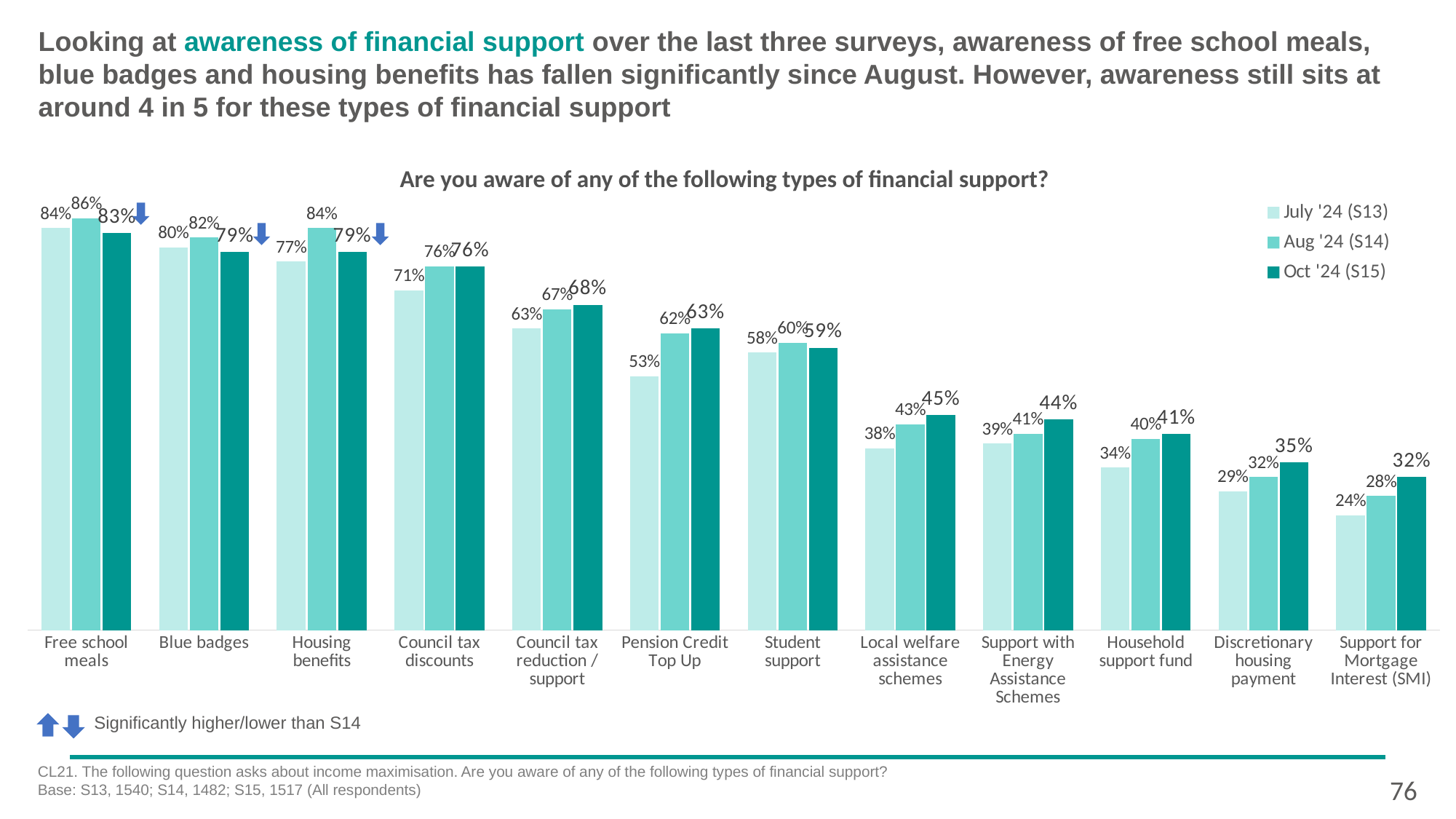
What is the title of the chart? Are you aware of any of the following types of financial support? How many types of financial support are shown on the x axis? 12 What is the difference between the Aug '24 (S14) and Oct '24 (S15) values for Housing benefits? 5 percentage points Which type of financial support has the highest Aug '24 (S14) awareness? Free school meals What is the Aug '24 (S14) awareness value for Housing benefits? 84% Which type of financial support has the lowest July '24 (S13) awareness? Support for Mortgage Interest (SMI) What is the Oct '24 (S15) awareness value for Free school meals? 83% What is the July '24 (S13) awareness value for Pension Credit Top Up? 53% Do the Oct '24 (S15) values generally rise or fall moving from left to right across the categories? fall How many series does the legend list? 3 What type of chart is shown on the slide? bar chart Which is larger for Discretionary housing payment: the July '24 (S13) value or the Oct '24 (S15) value? Oct '24 (S15)